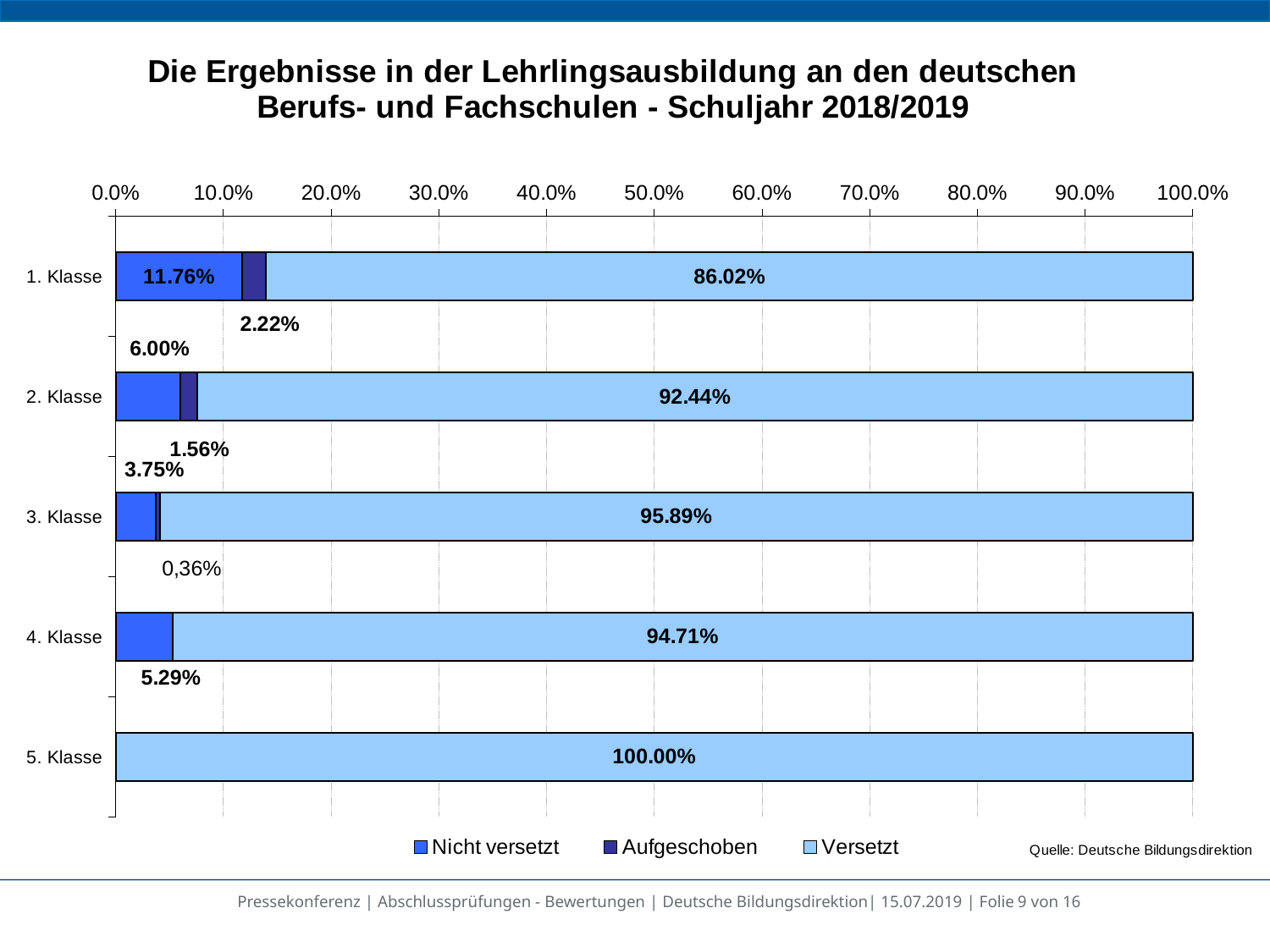
What is the 'Versetzt' value for 1. Klasse? 86.02% What is the 'Nicht versetzt' value for 1. Klasse? 11.76% Which class has the highest 'Versetzt' value? 5. Klasse How many series does the legend list? 3 How many classes (categories) are shown on the chart? 5 What is the 'Versetzt' value for 3. Klasse? 95.89% What is the difference between the 'Versetzt' values for 2. Klasse and 1. Klasse? 6.42% Which class has the lowest 'Versetzt' value? 1. Klasse Which series is shown in the lightest blue colour in the legend? Versetzt What type of chart is shown on the slide? stacked bar chart Which is larger, the 'Versetzt' value for 3. Klasse or for 4. Klasse? 3. Klasse What is the 'Versetzt' value for 5. Klasse? 100.00%